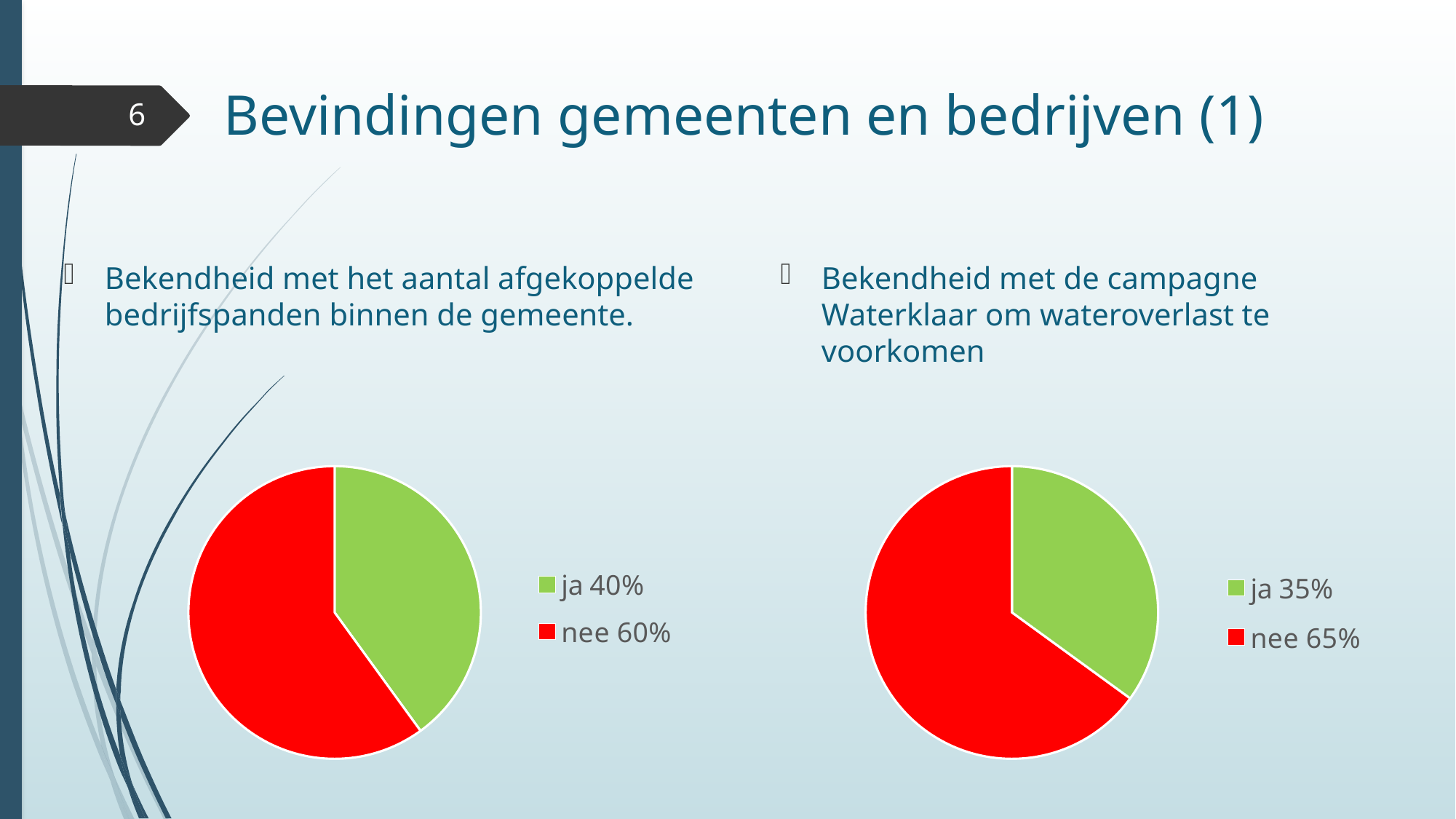
In the left pie chart, which slice is the largest? nee In the right pie chart, which slice is the smallest? ja In the left pie chart (about afgekoppelde bedrijfspanden), what share is labelled 'ja'? 40% In the left pie chart (about afgekoppelde bedrijfspanden), what share is labelled 'nee'? 60% In the left pie chart, what is the difference between the 'nee' and 'ja' shares? 20% In the right pie chart (about the campagne Waterklaar), what share is labelled 'ja'? 35% What type of chart is used on the left of the slide? pie chart Which is larger: the 'ja' share in the left pie chart or the 'ja' share in the right pie chart? the left pie chart (40%) How many slices does the right pie chart have? 2 In the right pie chart, what is the difference between the 'nee' and 'ja' shares? 30% In the left pie chart, what colour is the 'nee' slice? red